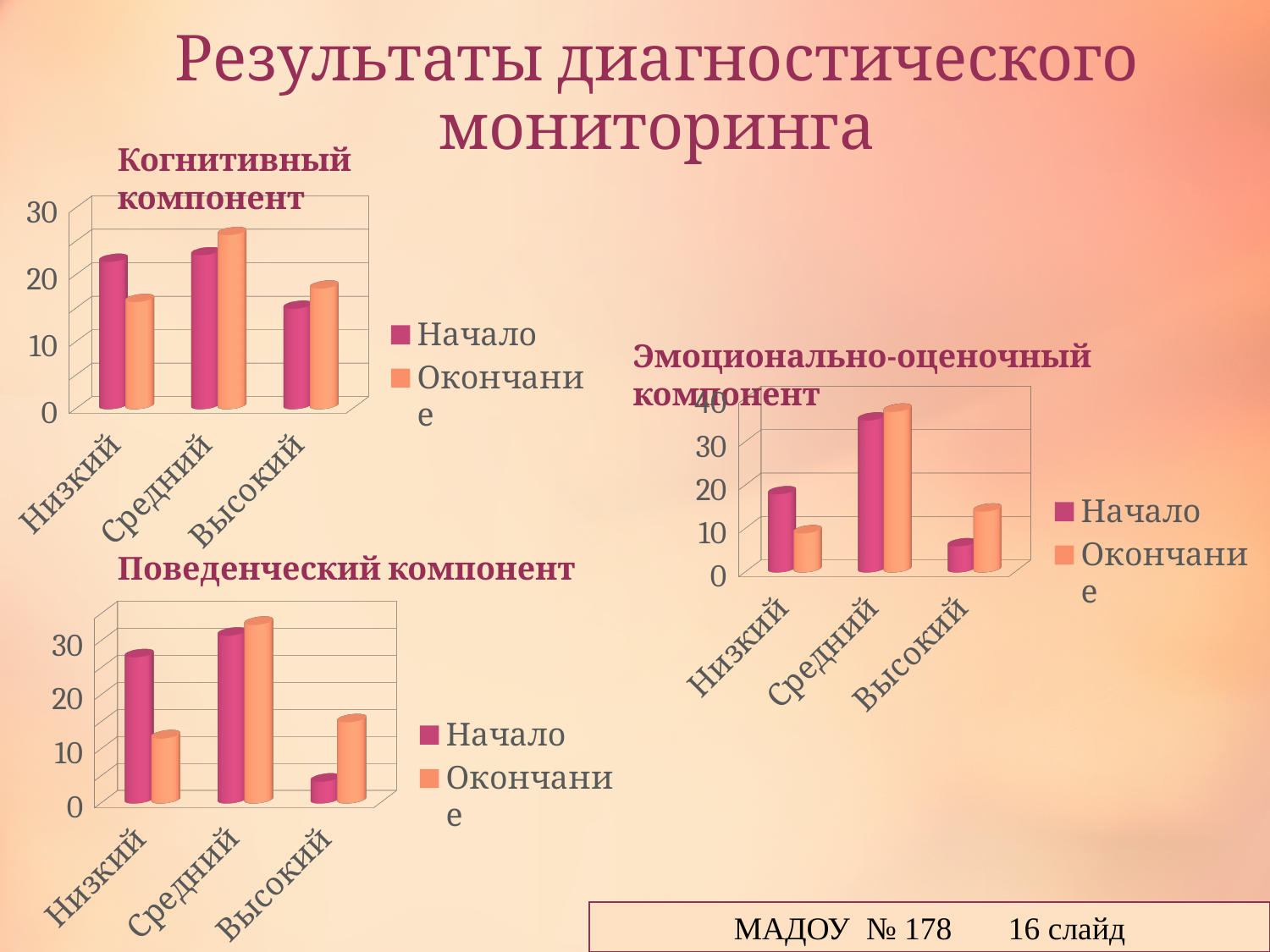
In the "Поведенческий компонент" chart, is the "Начало" value for "Высокий" greater or less than 10? less How many categories are shown on the x axis of the "Эмоционально-оценочный компонент" chart? 3 What are the two legend entries in the "Когнитивный компонент" chart? Начало, Окончание In the "Поведенческий компонент" chart, which is larger for "Высокий": "Начало" or "Окончание"? Окончание How many series does the legend of the "Поведенческий компонент" chart list? 2 In the "Когнитивный компонент" chart, which is larger for "Низкий": "Начало" or "Окончание"? Начало In the "Поведенческий компонент" chart, which category has the highest "Окончание" value? Средний In the "Эмоционально-оценочный компонент" chart, which category has the lowest "Начало" value? Высокий In the "Поведенческий компонент" chart, is the "Начало" value for "Низкий" greater or less than 20? greater In the "Эмоционально-оценочный компонент" chart, is the "Окончание" value for "Средний" greater or less than 30? greater What kind of chart is the "Когнитивный компонент" chart? bar chart